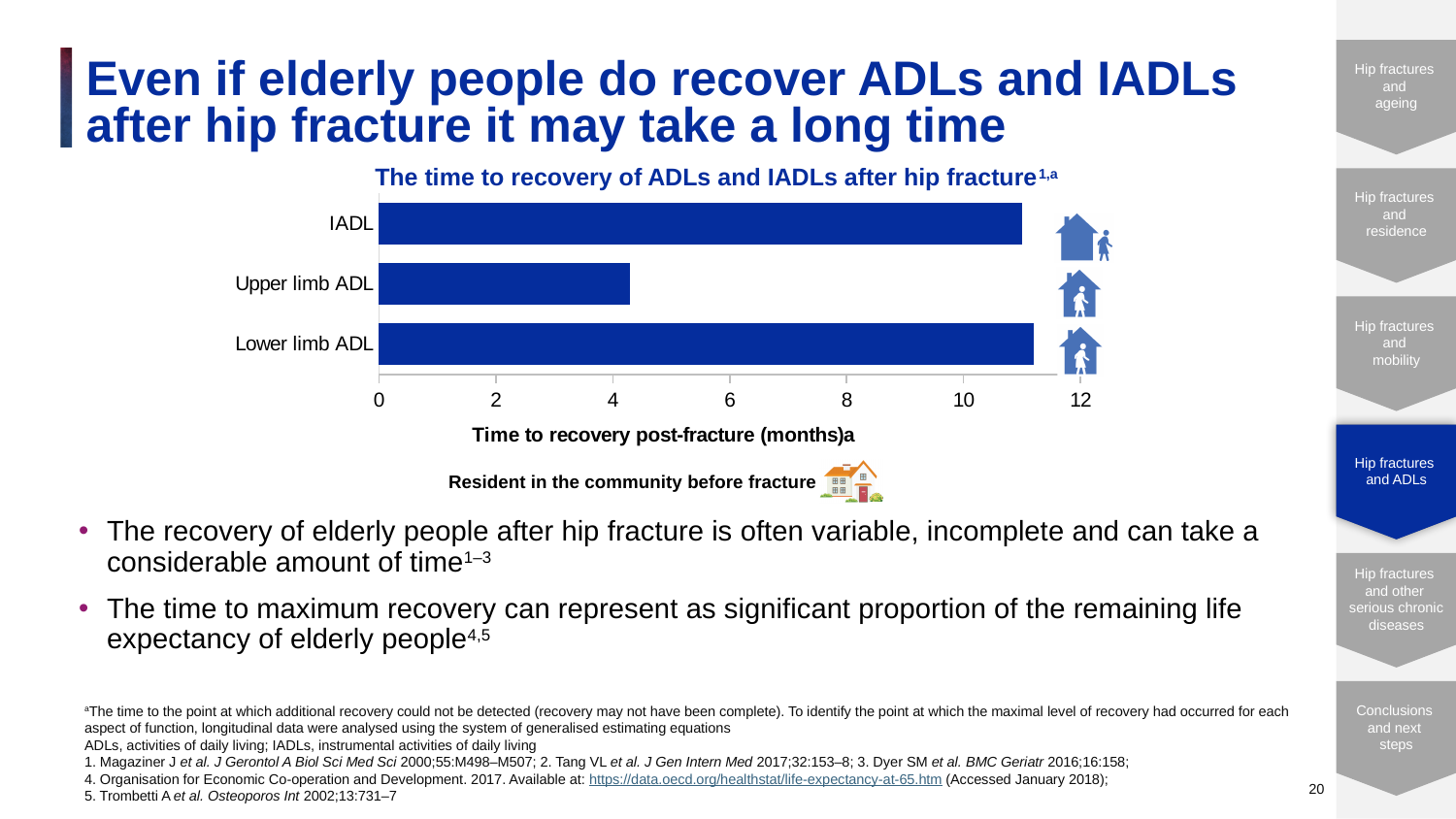
What is the label of the horizontal axis of the chart? Time to recovery post-fracture (months) What kind of chart is shown on the slide? bar chart Is the time to recovery for Lower limb ADL greater or less than 10 months? greater Is the time to recovery for IADL greater or less than 10 months? greater How many categories are plotted in the chart? 3 Which category has the shortest time to recovery post-fracture? Upper limb ADL Is the time to recovery for Upper limb ADL greater or less than 8 months? less Which has a longer time to recovery, IADL or Upper limb ADL? IADL What is the title of the chart? The time to recovery of ADLs and IADLs after hip fracture Which has a longer time to recovery, Lower limb ADL or Upper limb ADL? Lower limb ADL